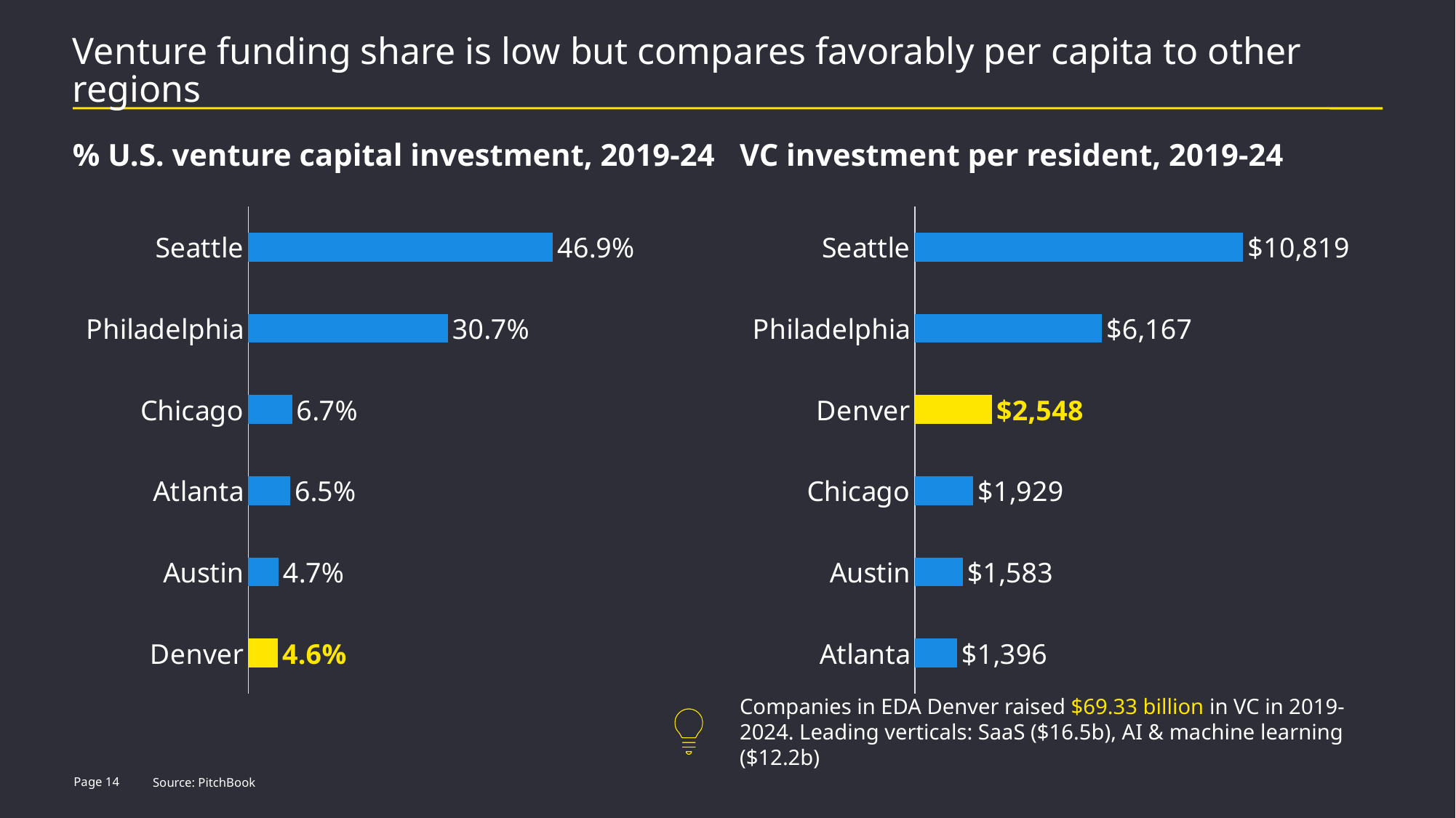
In the 'VC investment per resident, 2019-24' chart, which city has the lowest value? Atlanta In the 'VC investment per resident, 2019-24' chart, what is the value for Denver? $2,548 What type of chart is the '% U.S. venture capital investment, 2019-24' chart? Bar chart In the 'VC investment per resident, 2019-24' chart, what is the difference between Seattle and Philadelphia? $4,652 In the 'VC investment per resident, 2019-24' chart, which is larger, Denver or Chicago? Denver In the 'VC investment per resident, 2019-24' chart, which city's bar is highlighted in yellow? Denver In the '% U.S. venture capital investment, 2019-24' chart, what is the value for Seattle? 46.9% In the '% U.S. venture capital investment, 2019-24' chart, what is the difference between Seattle and Philadelphia? 16.2% In the 'VC investment per resident, 2019-24' chart, which city has the highest value? Seattle How many cities are shown in the 'VC investment per resident, 2019-24' chart? 6 In the '% U.S. venture capital investment, 2019-24' chart, which city has the lowest value? Denver In the '% U.S. venture capital investment, 2019-24' chart, which is larger, Philadelphia or Chicago? Philadelphia